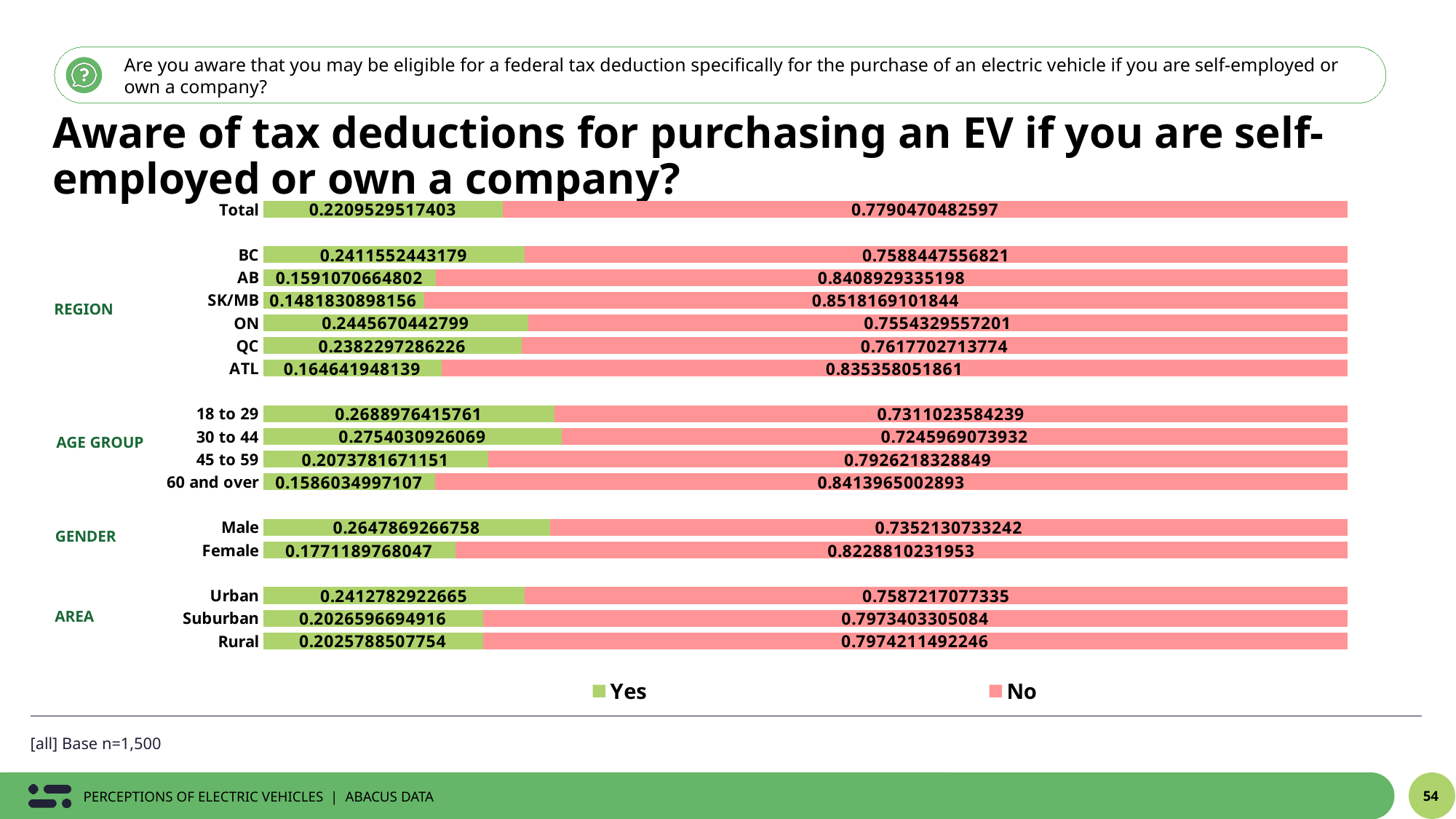
What is the Yes value for Total? 0.2209529517403 What is the No value for SK/MB? 0.8518169101844 What kind of chart is shown on the slide? Stacked bar chart Which category has the highest Yes value? 30 to 44 What is the difference between the Yes values for Male and Female? 0.0876679498711 Which has a larger Yes value, Male or Female? Male What colour represents the No series in the chart? Red (pink) How many series does the legend list? 2 What is the Yes value for 60 and over? 0.1586034997107 How many categories are plotted in the chart? 16 What is the No value for Urban? 0.7587217077335 Which category has the lowest Yes value? SK/MB